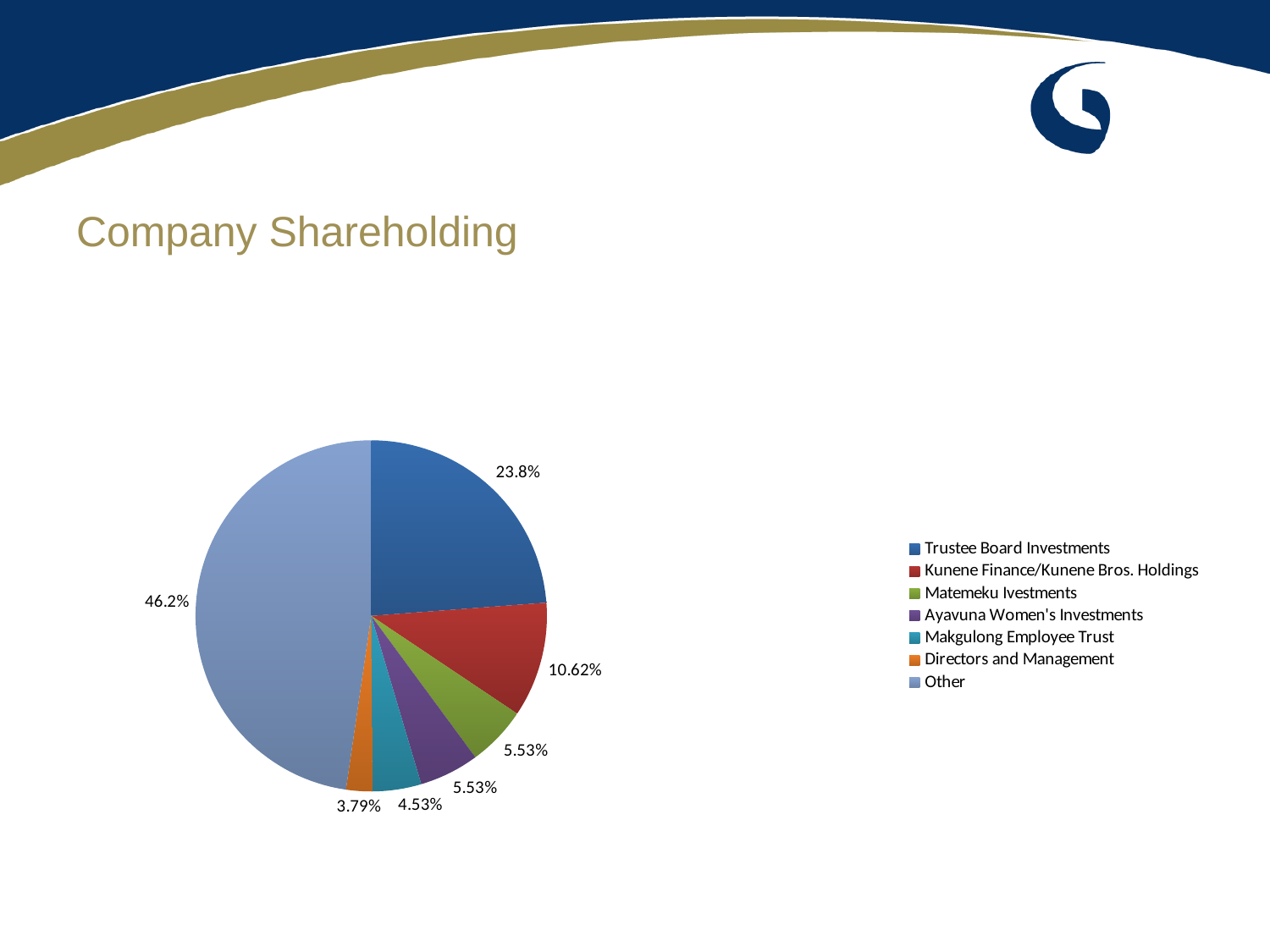
Which category has the largest slice of the pie? Other What is the title of the slide containing the pie chart? Company Shareholding What share of the pie does Makgulong Employee Trust hold? 4.53% What share of the pie does Trustee Board Investments hold? 23.8% Which is larger, the share of Makgulong Employee Trust or the share of Directors and Management? Makgulong Employee Trust What share of the pie does Kunene Finance/Kunene Bros. Holdings hold? 10.62% What share of the pie does Directors and Management hold? 3.79% Which category has the smallest slice of the pie? Directors and Management What kind of chart is shown on the slide? pie chart How many categories are shown in the pie chart? 7 What share of the pie does Other hold? 46.2% What is the difference between the shares of Trustee Board Investments and Kunene Finance/Kunene Bros. Holdings? 13.18%